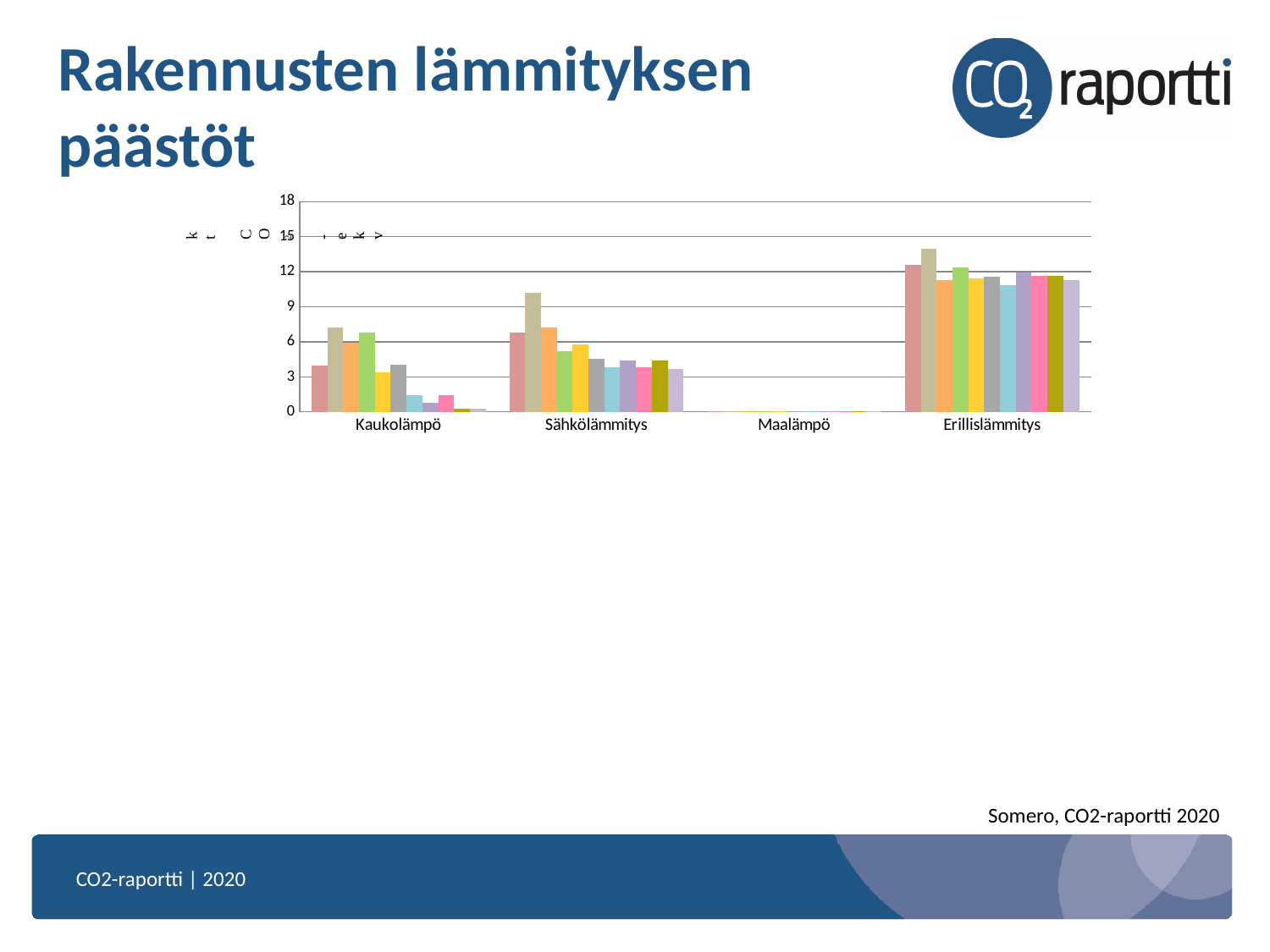
Is the tallest bar in the Erillislämmitys group greater or less than 12? greater How many categories are shown on the x axis of the chart? 4 What is the highest value shown on the y axis of the chart? 18 Are the bars for Maalämpö greater or less than 3? less What is the title of the slide containing the chart? Rakennusten lämmityksen päästöt Are the bars for Erillislämmitys taller or shorter than the bars for Kaukolämpö? taller Is the tallest bar in the Sähkölämmitys group greater or less than 12? less Which category on the x axis has the lowest bars? Maalämpö Which category is listed first on the x axis? Kaukolämpö Which category on the x axis has the tallest bars? Erillislämmitys What kind of chart is shown on the slide? bar chart